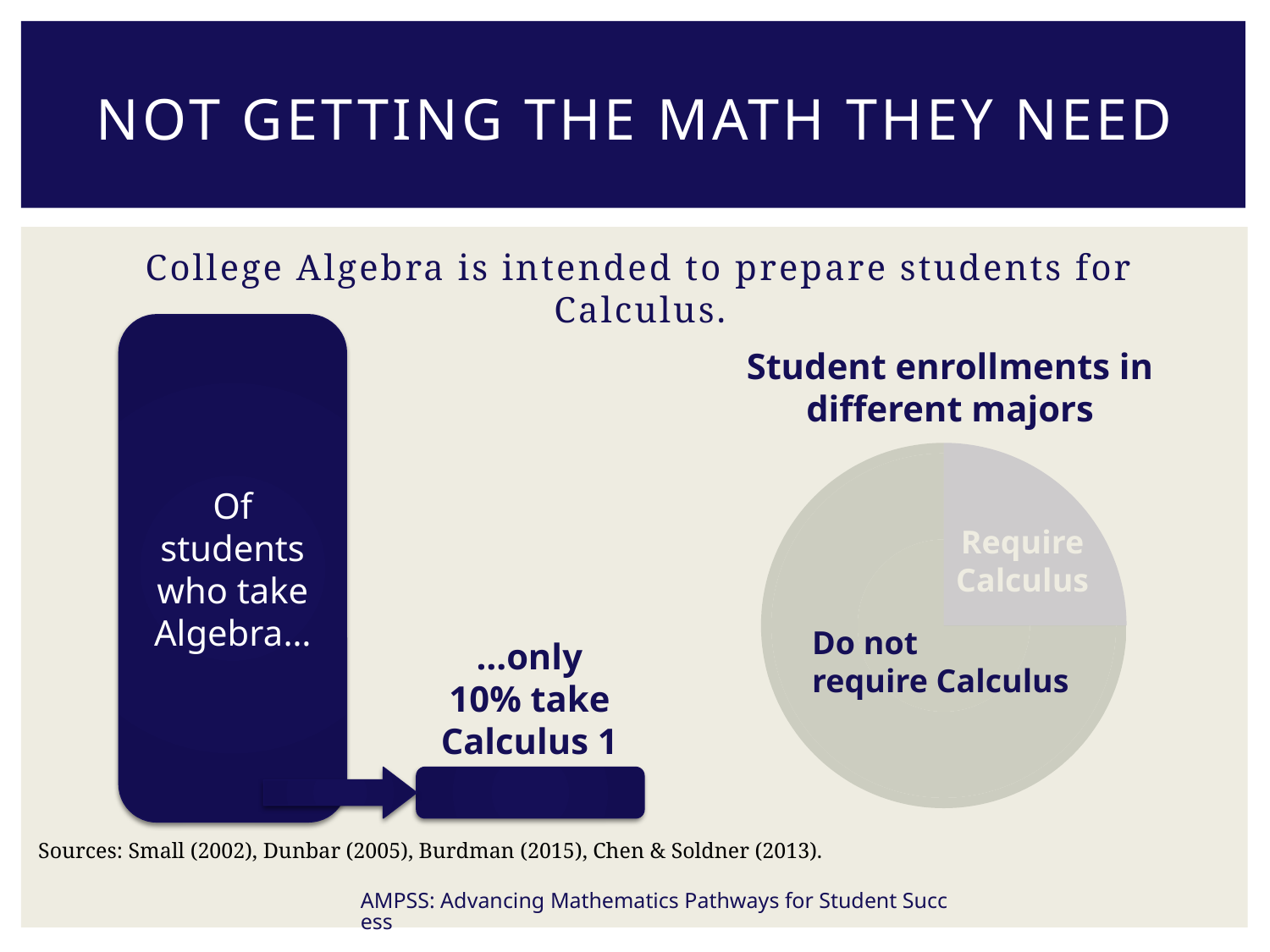
What is the title of the pie chart on the right side of the slide? Student enrollments in different majors In the 'Student enrollments in different majors' pie chart, which slice is the smallest? Require Calculus What kind of chart is the 'Student enrollments in different majors' chart? pie chart How many slices does the 'Student enrollments in different majors' pie chart have? 2 What are the labels of the two slices in the 'Student enrollments in different majors' pie chart? Require Calculus; Do not require Calculus In the 'Student enrollments in different majors' pie chart, which slice is larger: 'Require Calculus' or 'Do not require Calculus'? Do not require Calculus In the 'Student enrollments in different majors' pie chart, which slice is the largest? Do not require Calculus